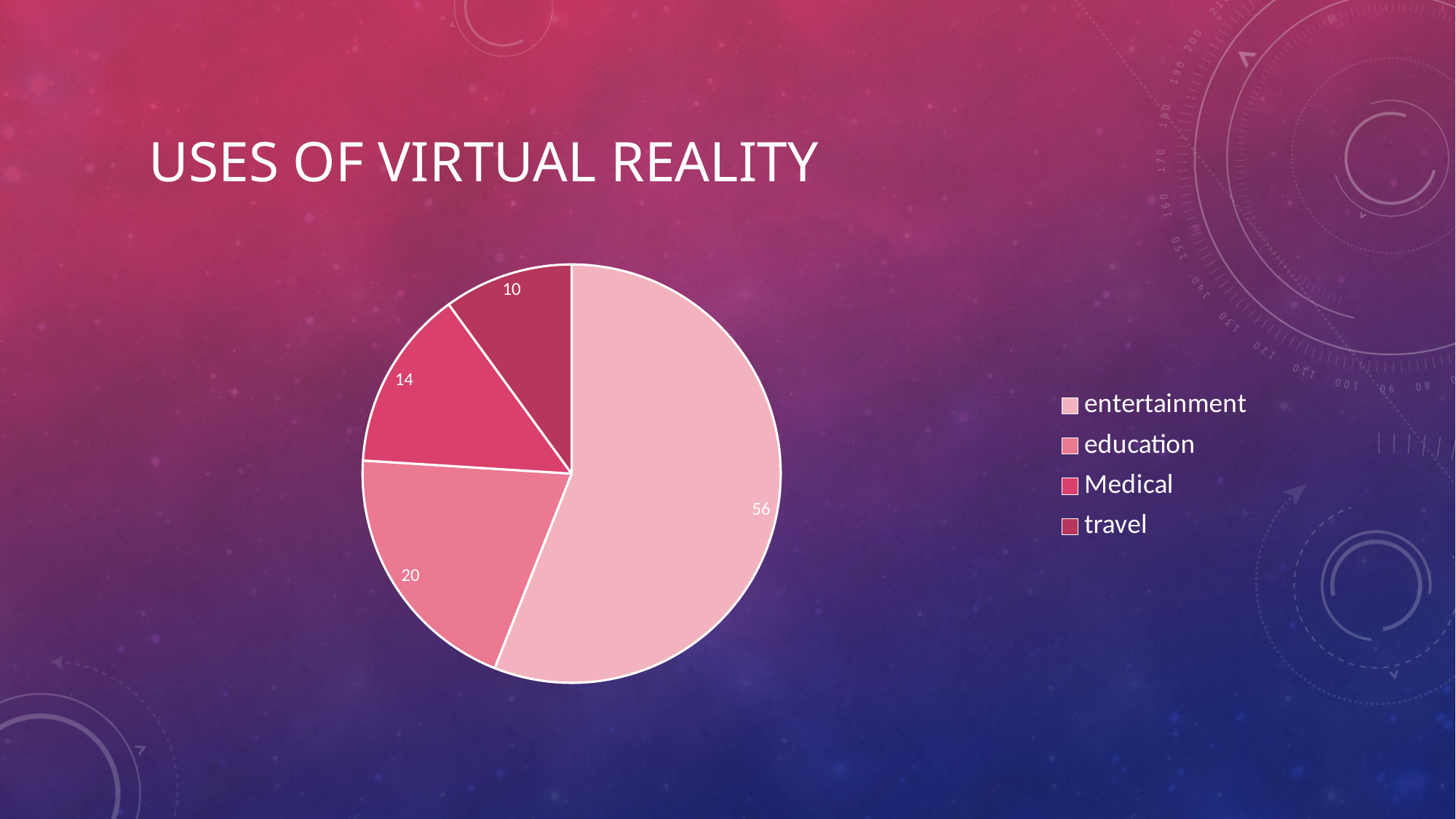
How many categories does the pie chart have? 4 What is the difference between the values for entertainment and education? 36 Which is larger, the value for Medical or the value for travel? Medical What is the value for entertainment? 56 What kind of chart is shown on the slide? pie chart Which category has the smallest slice? travel What share of the pie does entertainment represent? 56% What is the title of the slide containing the chart? USES OF VIRTUAL REALITY What is the value for Medical? 14 Which category has the largest slice? entertainment What is the value for education? 20 What is the value for travel? 10